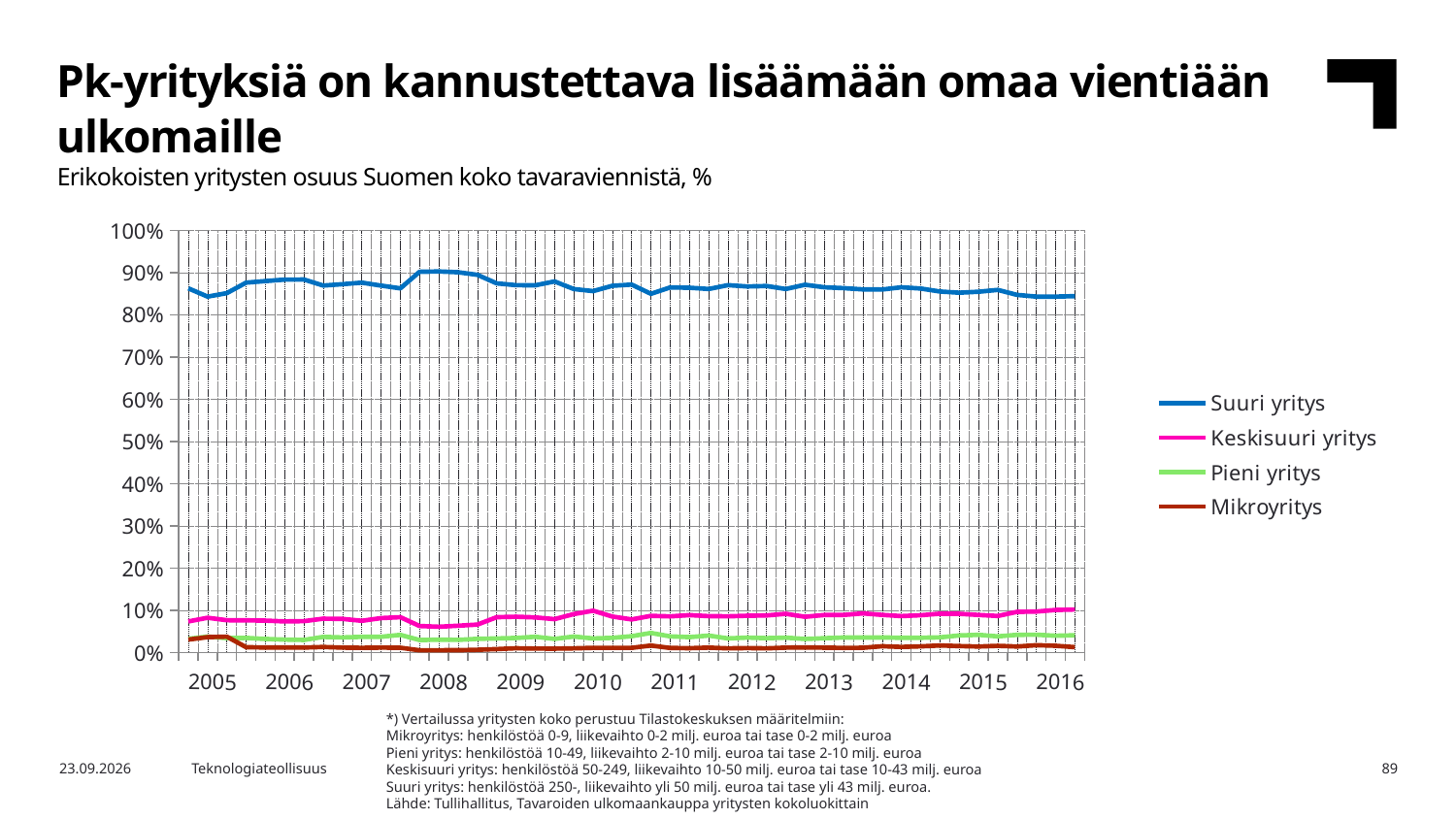
How many series does the legend list? 4 Is the value for Pieni yritys in 2012 greater or less than 10%? less Is the value for Suuri yritys in 2008 greater or less than 80%? greater Which series is drawn in blue in the legend? Suuri yritys What is the subtitle describing what the chart shows? Erikokoisten yritysten osuus Suomen koko tavaraviennistä, % Which series has the highest share of Finland's goods exports throughout the period? Suuri yritys Which is larger in 2014, the value for Suuri yritys or the value for Mikroyritys? Suuri yritys Which is larger in 2010, the value for Keskisuuri yritys or the value for Pieni yritys? Keskisuuri yritys How many years are labelled on the x axis? 12 What kind of chart is shown on the slide? line chart Is the value for Keskisuuri yritys in 2016 greater or less than 20%? less